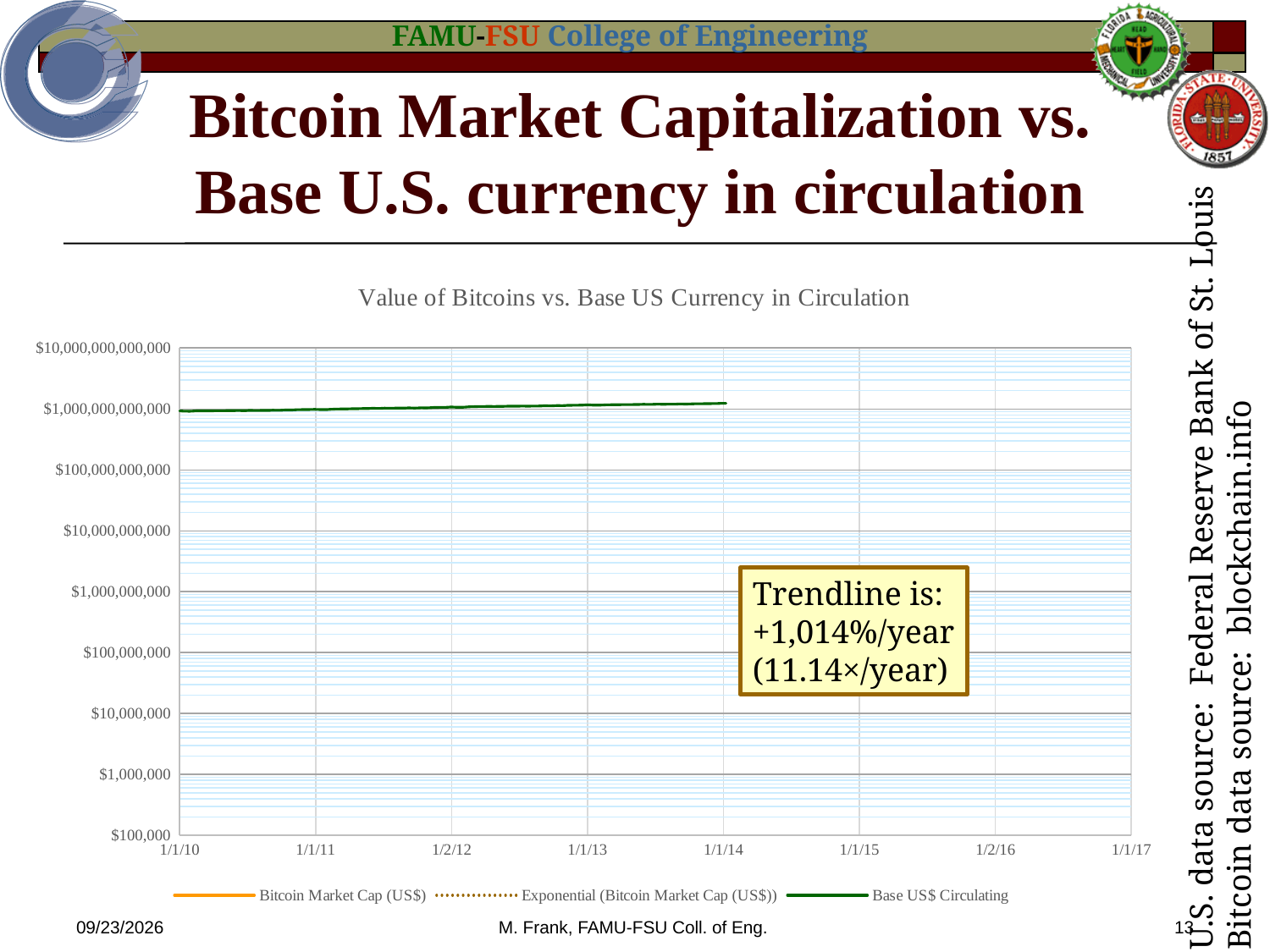
According to the annotation box, what is the trendline growth rate per year in percent? +1,014%/year Is the value of Base US$ Circulating at 1/1/10 greater or less than $10,000,000,000,000? less Does the Base US$ Circulating line rise or fall from 1/1/10 to 1/1/14? rises Which series is drawn as the solid green line? Base US$ Circulating How many date labels are shown along the x axis? 8 What kind of chart is shown on the slide? line chart What is the title of the chart? Value of Bitcoins vs. Base US Currency in Circulation Is the value of Base US$ Circulating at 1/1/12 greater or less than $10,000,000,000? greater What is the lowest value labelled on the y axis? $100,000 How many series does the chart legend list? 3 What is the highest value labelled on the y axis? $10,000,000,000,000 Is the value of Base US$ Circulating at 1/1/14 greater or less than $100,000,000,000? greater